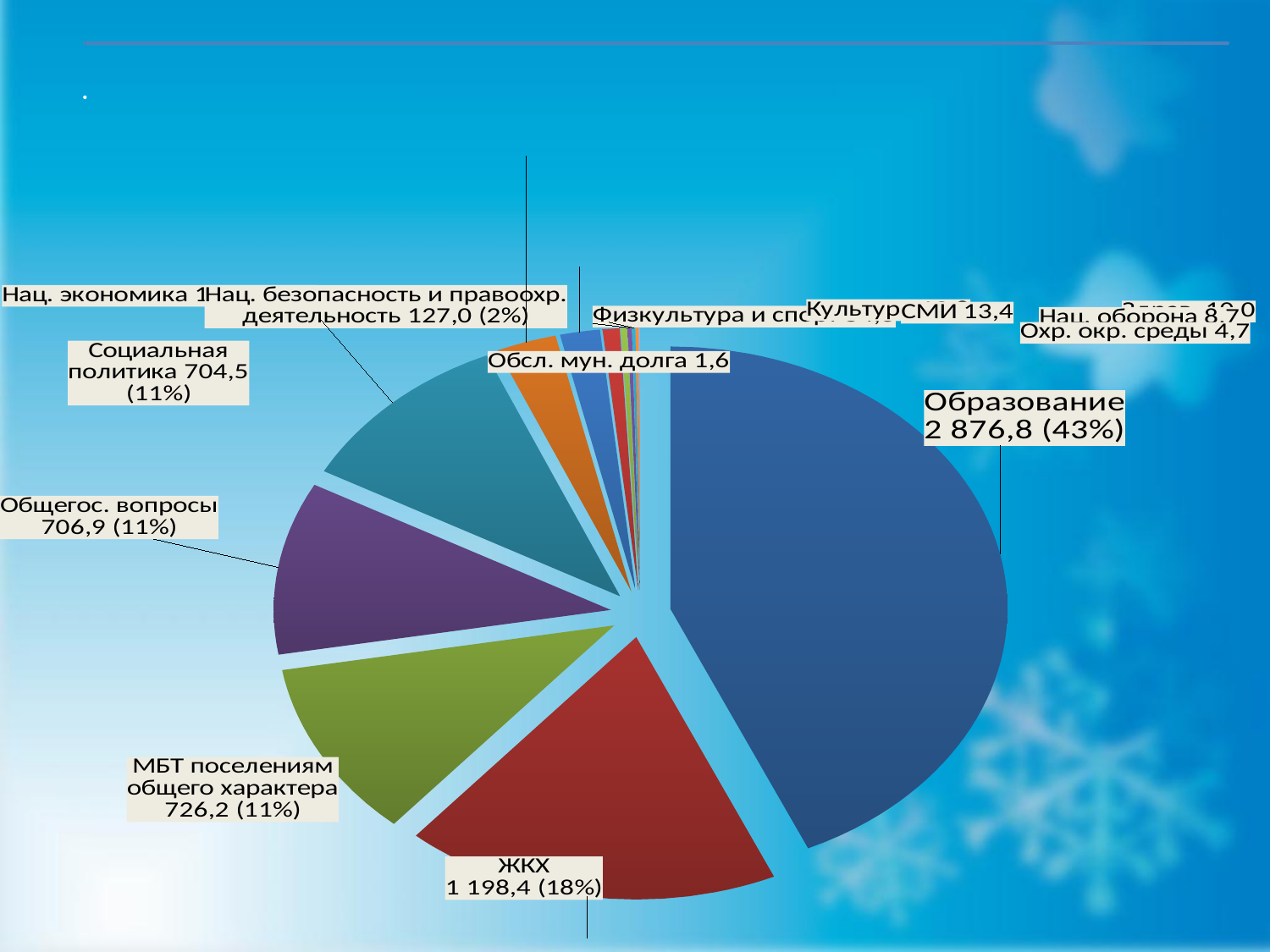
Which is larger, the value for ЖКХ or the value for Общегос. вопросы? ЖКХ What share of the pie does Образование represent? 43% What value is shown for Общегос. вопросы? 706,9 Which category has the largest slice of the pie? Образование What kind of chart is shown on the slide? pie chart What value is shown for ЖКХ? 1 198,4 What value is shown for Обсл. мун. долга? 1,6 What value is shown for МБТ поселениям общего характера? 726,2 What value is shown for Нац. безопасность и правоохр. деятельность? 127,0 What value is shown for Образование? 2 876,8 What share of the pie does ЖКХ represent? 18% What value is shown for Социальная политика? 704,5